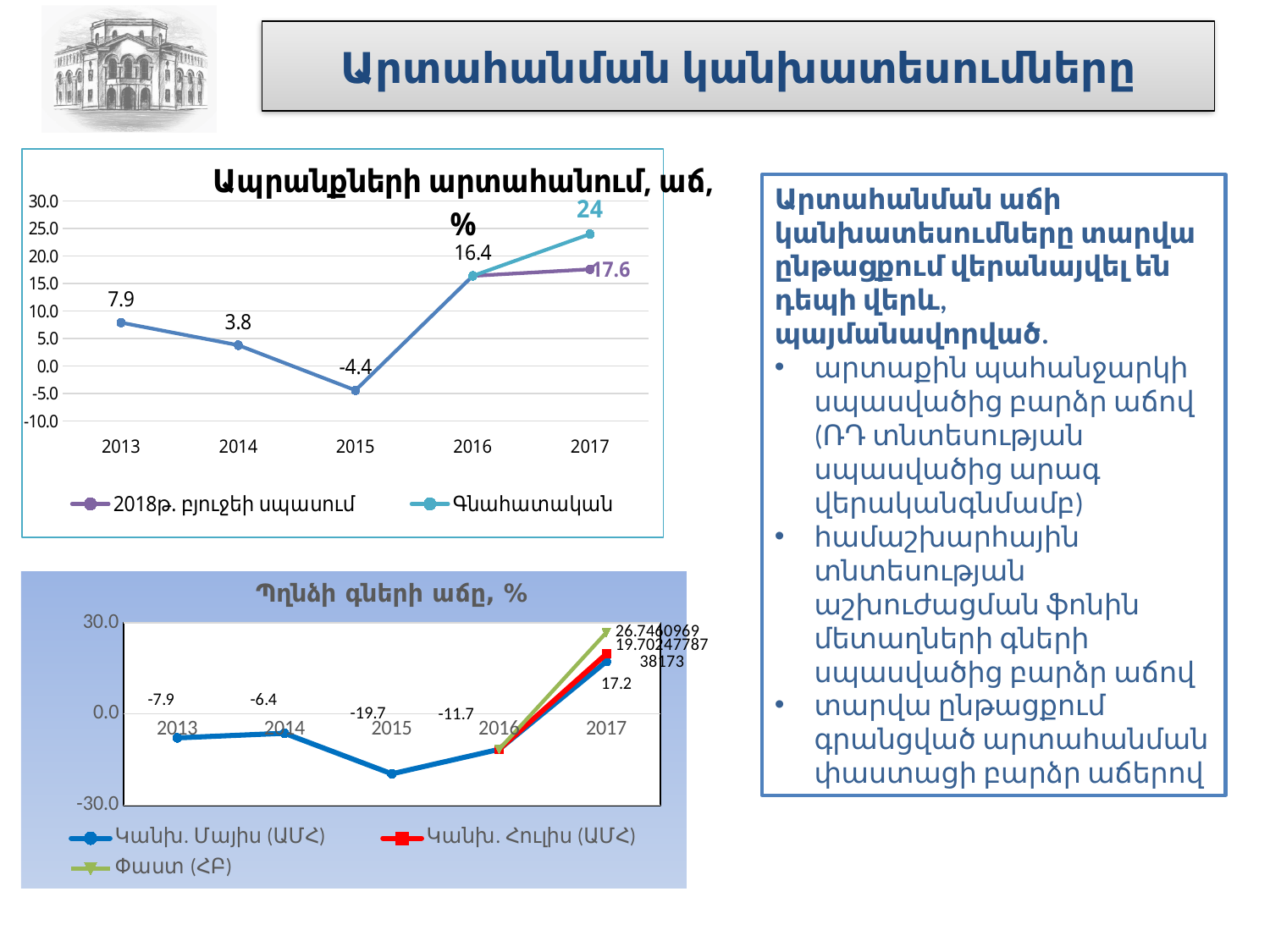
In the top chart (Ապրանքների արտահանում, աճ, %), which year has the lowest value? 2015 In the top chart (Ապրանքների արտահանում, աճ, %), what is the difference between the 2016 value and the 2014 value? 12.6 In the top chart (Ապրանքների արտահանում, աճ, %), what is the value for 2013? 7.9 In the top chart (Ապրանքների արտահանում, աճ, %), what is the Գնահատական value for 2017? 24 In the top chart (Ապրանքների արտահանում, աճ, %), what is the 2018թ. բյուջեի սպասում value for 2017? 17.6 In the top chart (Ապրանքների արտահանում, աճ, %), how many years are shown on the x axis? 5 In the top chart (Ապրանքների արտահանում, աճ, %), how many series does the legend list? 2 In the bottom chart (Պղնձի գների աճը, %), what is the value for 2013? -7.9 In the top chart (Ապրանքների արտահանում, աճ, %), what is the value for 2015? -4.4 What kind of chart is the bottom chart (Պղնձի գների աճը, %)? Line chart In the bottom chart (Պղնձի գների աճը, %), how many series does the legend list? 3 In the bottom chart (Պղնձի գների աճը, %), which year has the lowest value? 2015